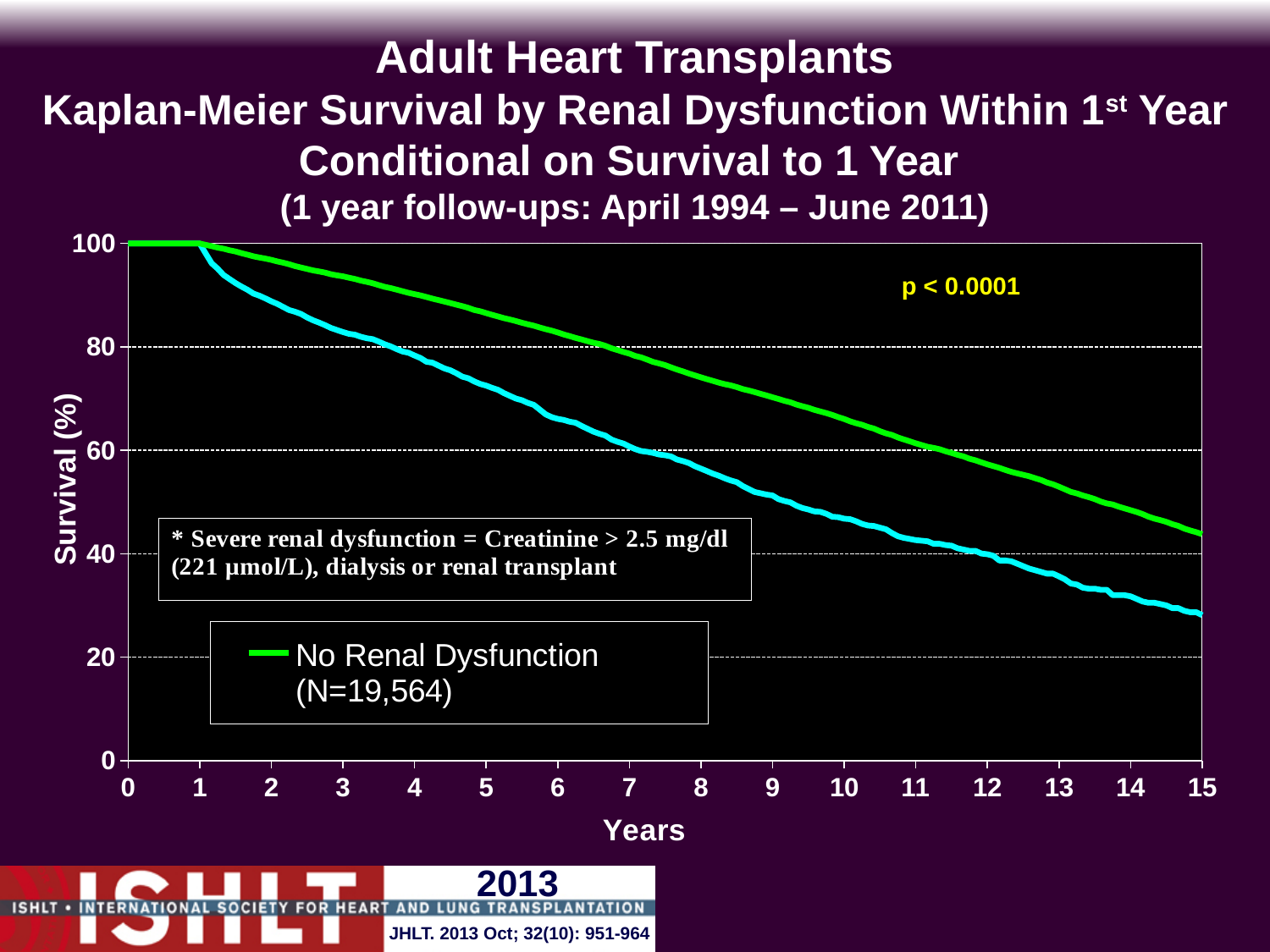
Is the survival for No Renal Dysfunction at 15 years greater or less than 60? less Is the survival for No Renal Dysfunction at 5 years greater or less than 80? greater What kind of chart is shown on the slide? line chart Is the survival for No Renal Dysfunction at 10 years greater or less than 60? greater What is the label of the y axis? Survival (%) What is the survival value for the No Renal Dysfunction line at year 0? 100 What is the maximum value shown on the x axis (Years)? 15 Does the No Renal Dysfunction survival curve rise or fall as years increase? fall What is the N for the No Renal Dysfunction group shown in the legend? N=19,564 How many series does the legend list? 1 What p-value is printed on the chart? p < 0.0001